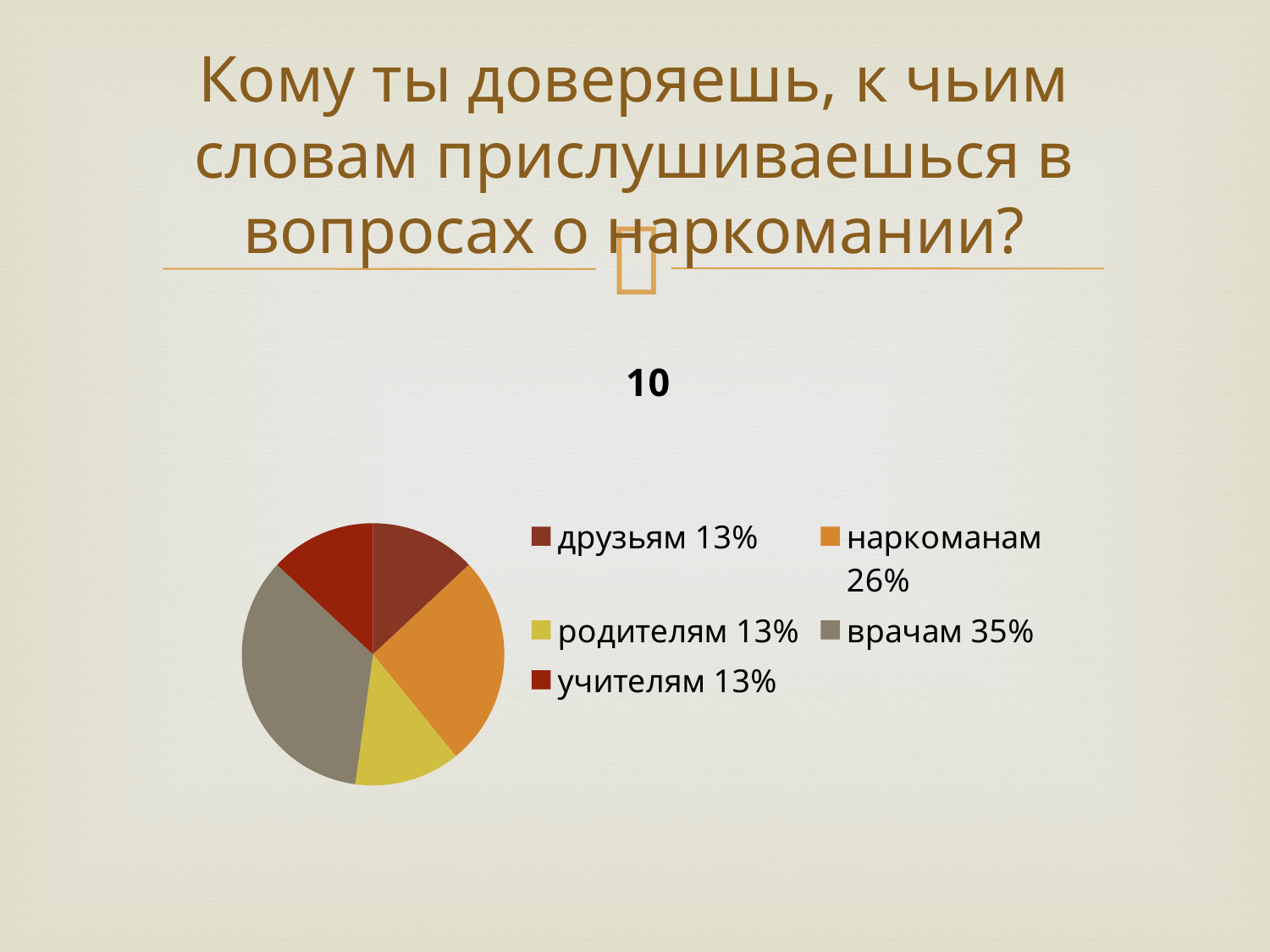
How many slices does the pie chart have? 5 What is the difference between the share for наркоманам and the share for учителям? 13% What share of the pie is labelled for родителям? 13% What is the title shown above the pie chart? 10 Which is larger, the slice for наркоманам or the slice for друзьям? наркоманам What kind of chart is shown on the slide? pie chart How many categories share the same value of 13%? 3 What share of the pie is labelled for наркоманам? 26% What share of the pie is labelled for врачам? 35% What colour is the slice for врачам? grey What is the difference between the share for врачам and the share for наркоманам? 9% Which category has the largest slice of the pie? врачам